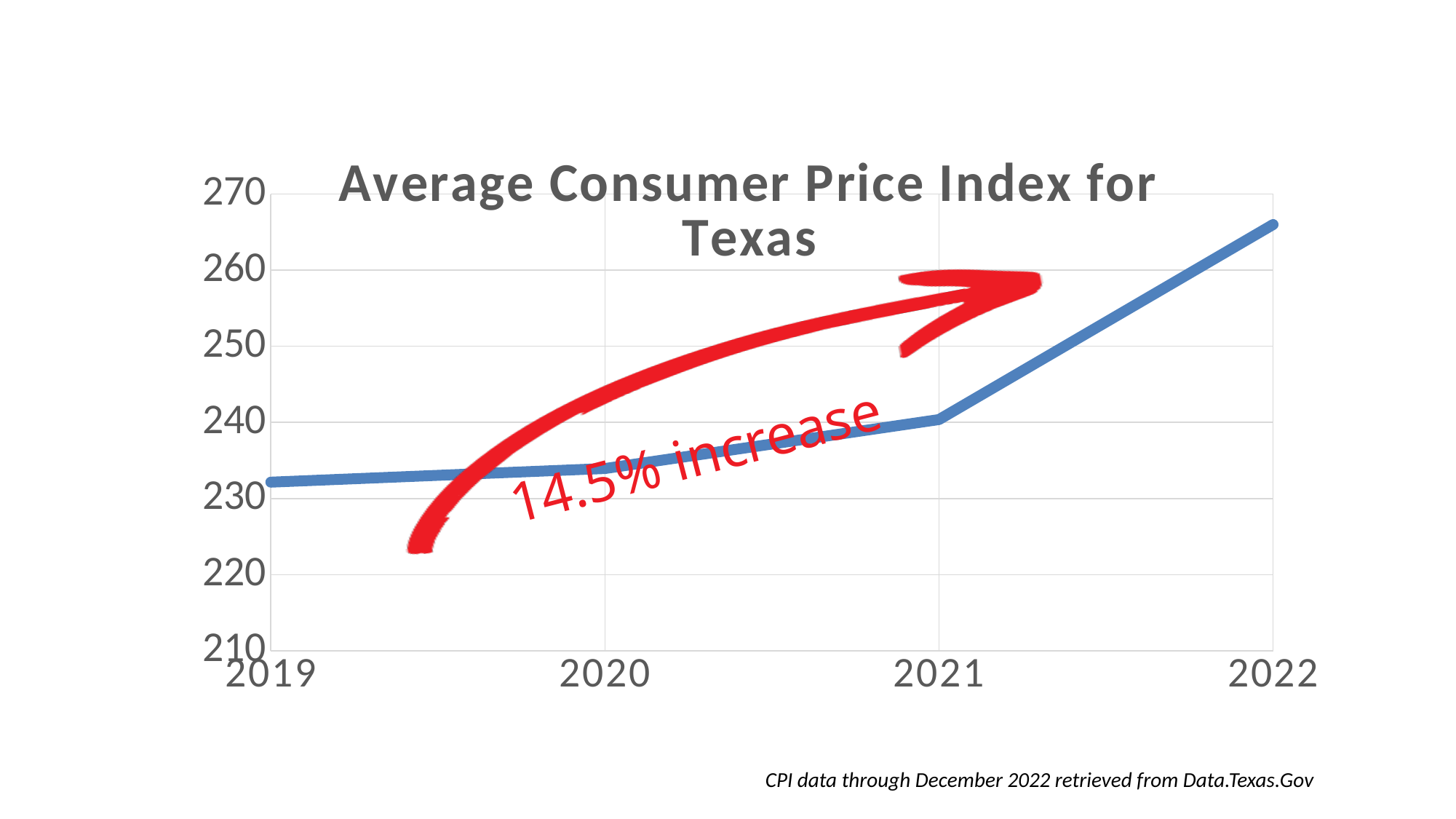
Which year has a higher Average Consumer Price Index for Texas, 2021 or 2022? 2022 What is the title of the chart? Average Consumer Price Index for Texas Is the value for 2019 greater or less than 230? greater How many years are plotted on the x axis of the chart? 4 Is the value for 2021 greater or less than 250? less What percentage increase does the red annotation on the chart state? 14.5% increase What kind of chart is shown on the slide? line chart Does the Average Consumer Price Index for Texas rise or fall from 2019 to 2022? rise Is the value for 2022 greater or less than 260? greater Which year has the lowest Average Consumer Price Index for Texas? 2019 Which year has the highest Average Consumer Price Index for Texas? 2022